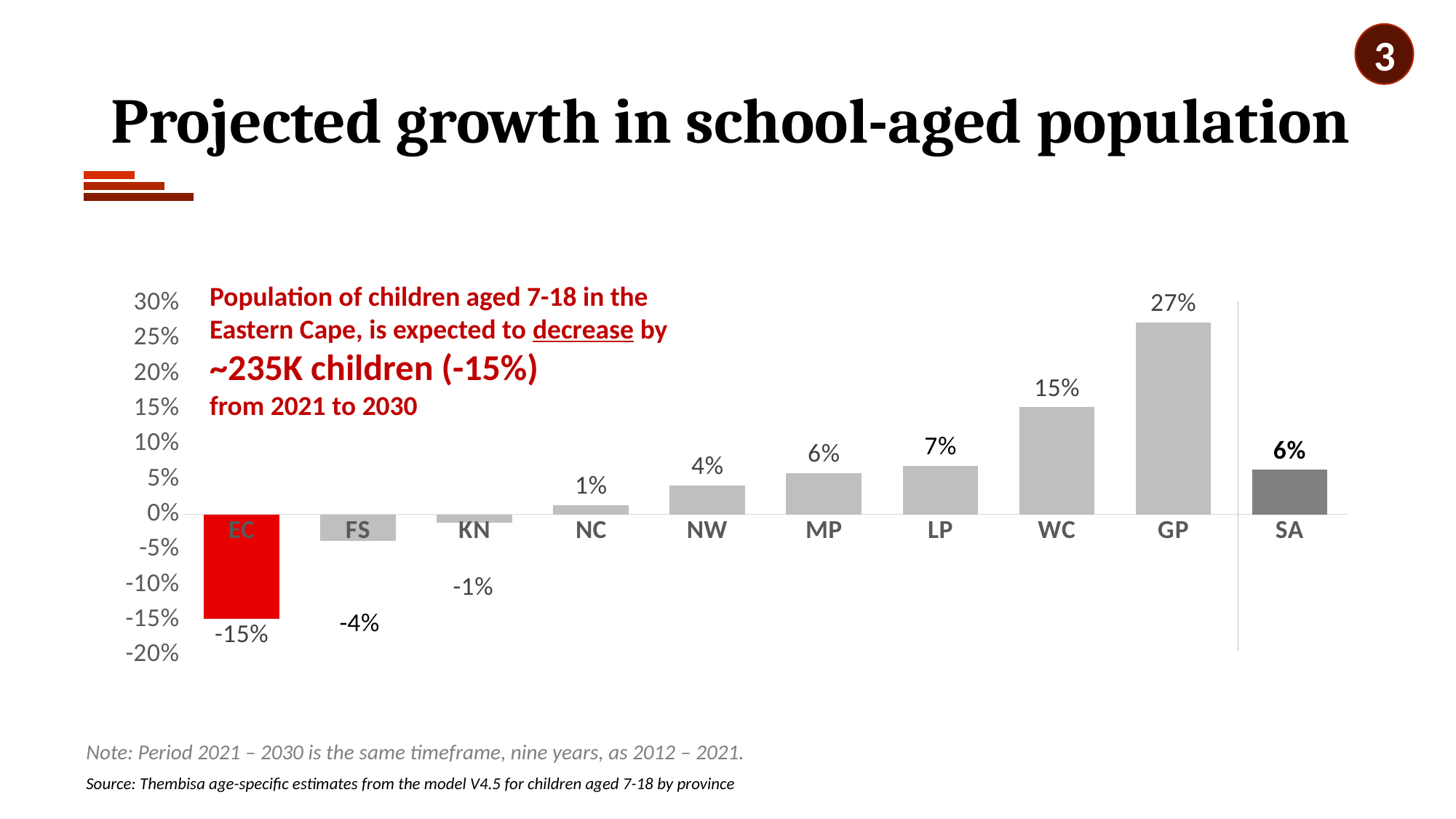
What is the projected growth value for GP? 27% Which has a larger value, LP or MP? LP Which category has the highest projected growth? GP What is the projected growth value for WC? 15% What kind of chart is shown on the slide? Bar chart What is the difference between the values for GP and WC? 12% How many categories are shown on the x axis? 10 Which bar is coloured red? EC Do the values generally rise or fall from EC to GP along the x axis? Rise Which category has the lowest projected growth? EC What is the projected growth value for SA? 6% What is the projected growth value for EC? -15%